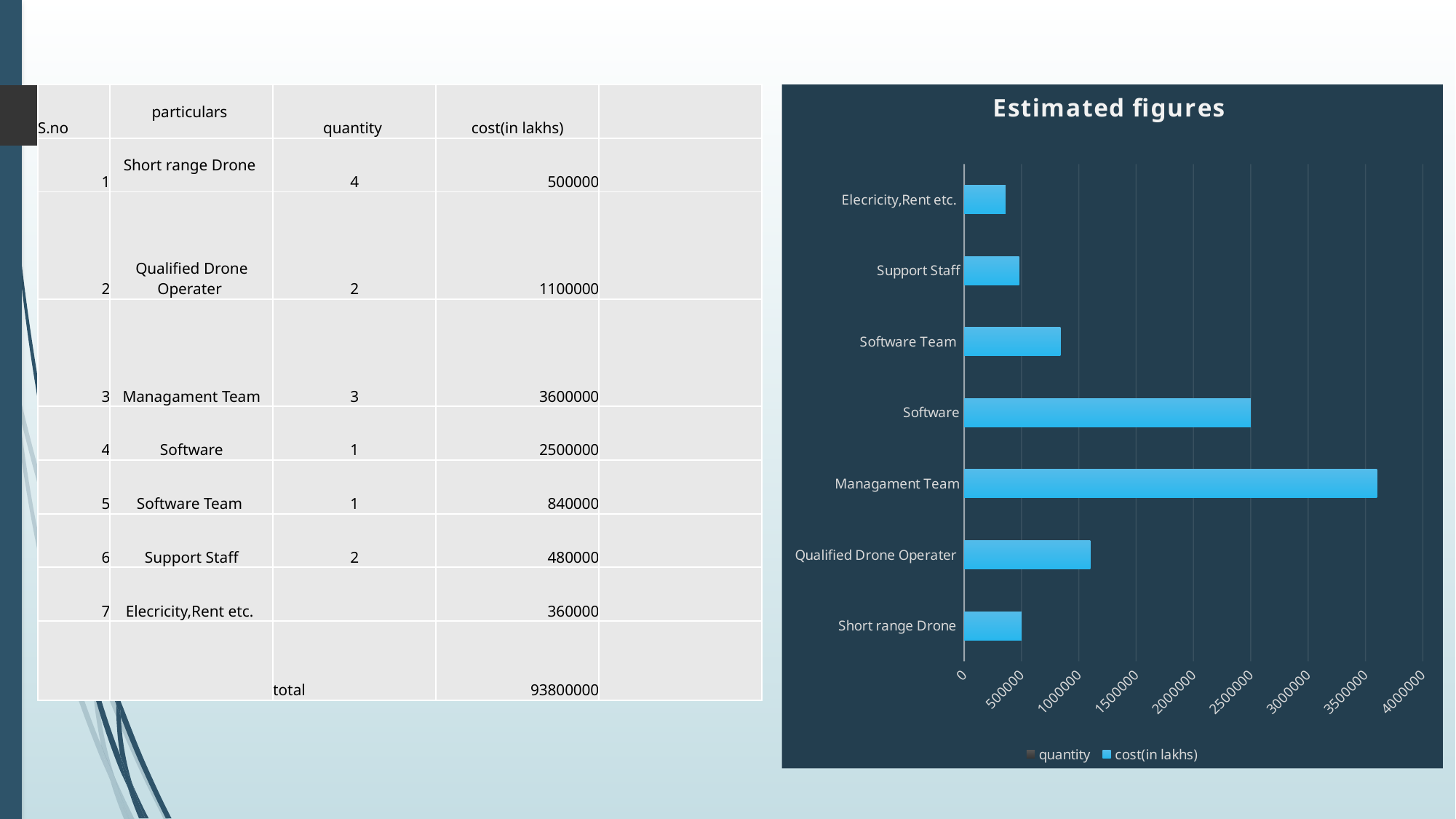
Is the cost(in lakhs) bar for Elecricity,Rent etc. greater or less than 500000? less Which has the larger cost(in lakhs) bar, Software Team or Qualified Drone Operater? Qualified Drone Operater Which category has the highest cost(in lakhs) bar in the chart? Managament Team Is the cost(in lakhs) bar for Managament Team greater or less than 3500000? greater What kind of chart is shown on the slide? bar chart What is the title of the chart? Estimated figures What is the cost(in lakhs) value for Short range Drone in the chart? 500000 How many categories are plotted in the chart? 7 Which category has the lowest cost(in lakhs) bar in the chart? Elecricity,Rent etc. How many series does the chart legend list? 2 Is the cost(in lakhs) bar for Software Team greater or less than 1000000? less Which has the larger cost(in lakhs) bar, Software or Qualified Drone Operater? Software